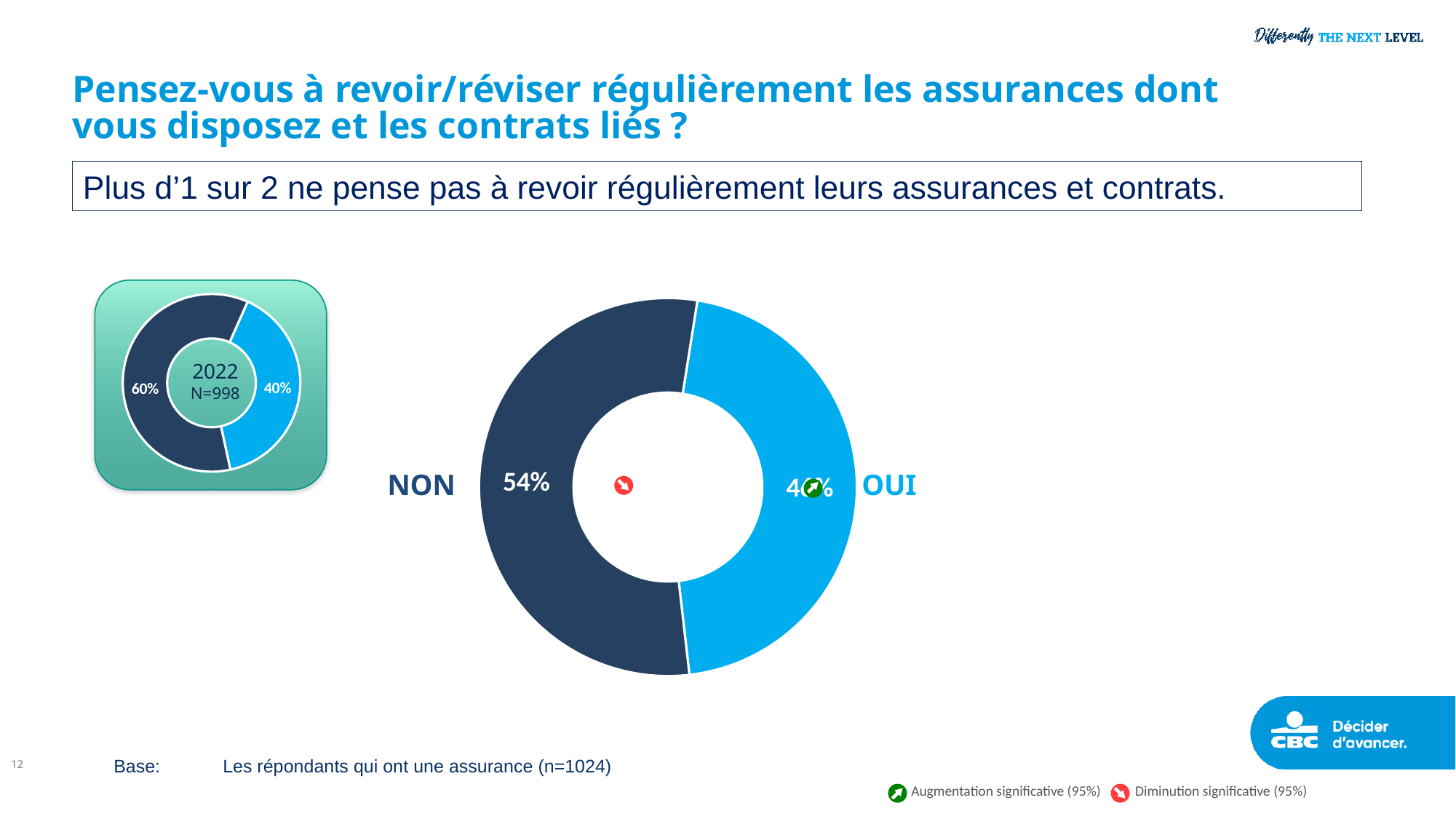
In the large donut chart, what percentage of respondents answered NON? 54% In the small 2022 donut chart, which segment is larger, the dark blue or the light blue one? Dark blue In the large donut chart, which answer has the larger share, NON or OUI? NON In the small 2022 donut chart on the left, what is the value of the dark blue segment? 60% In the small 2022 donut chart on the left, what is the value of the light blue segment? 40% How many categories does the large donut chart show? 2 In the small 2022 donut chart, what is the difference between the dark blue and light blue segments? 20 percentage points In the large donut chart, is the share for OUI greater or less than 50%? less What kind of chart is the large chart in the centre of the slide? Donut (pie) chart What sample size (N) is shown in the centre of the small 2022 donut chart? N=998 In the large donut chart, is the share for NON greater or less than 50%? greater What colour is the OUI segment in the large donut chart? Light blue